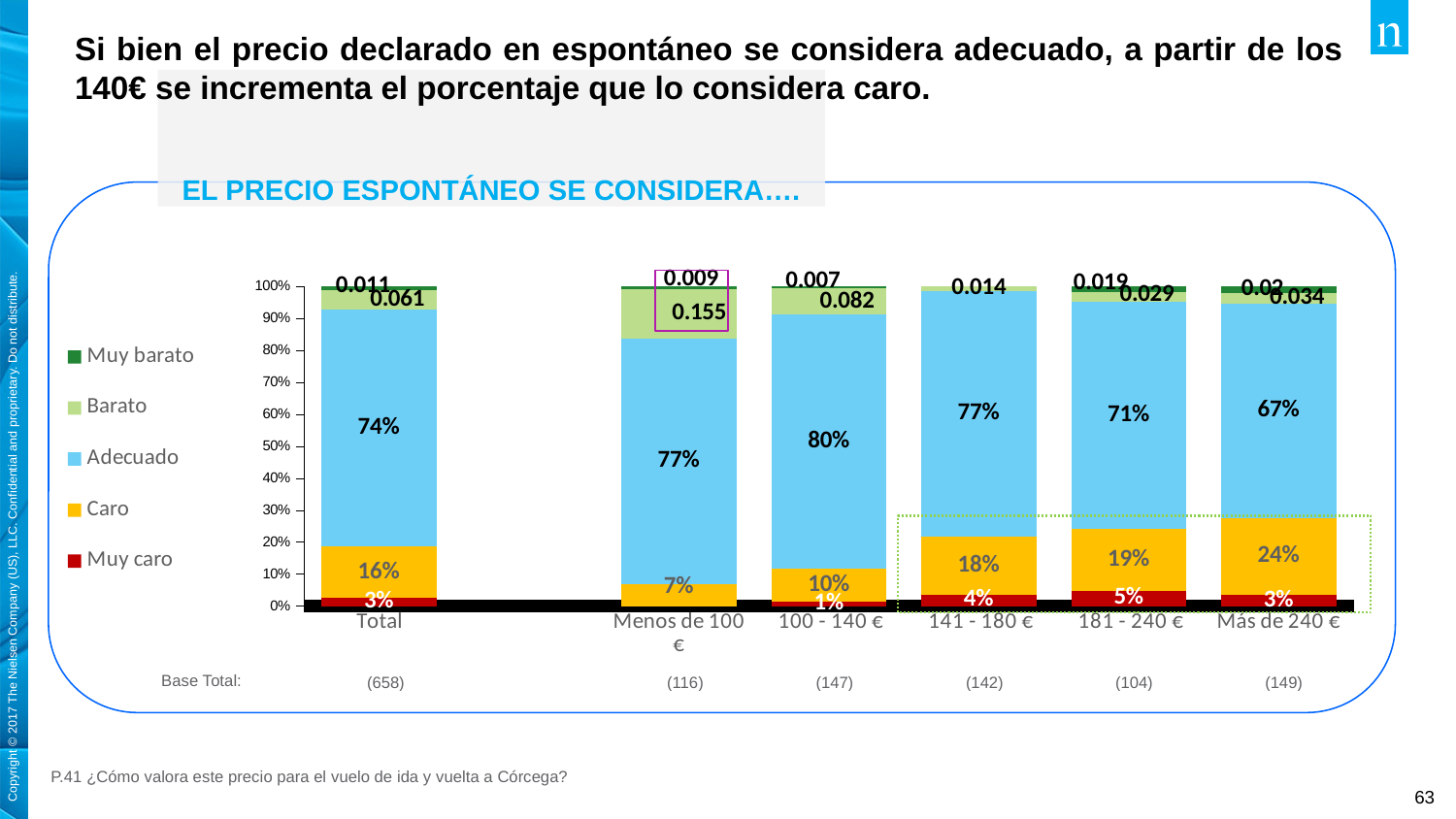
Which has the larger Adecuado value, 141 - 180 € or 181 - 240 €? 141 - 180 € How many price categories are shown along the x axis? 6 What is the Caro value for the Más de 240 € category? 24% Which category has the highest Adecuado value? 100 - 140 € Which category has the lowest Caro value? Menos de 100 € What is the Adecuado value for the Total category? 74% How many series does the legend list? 5 What is the Muy caro value for the 181 - 240 € category? 5% Which category has the highest Caro value? Más de 240 € What is the Barato value for the Menos de 100 € category? 0.155 What kind of chart is shown on the slide? Stacked bar chart What is the difference between the Caro value for Más de 240 € and the Caro value for Total? 8%